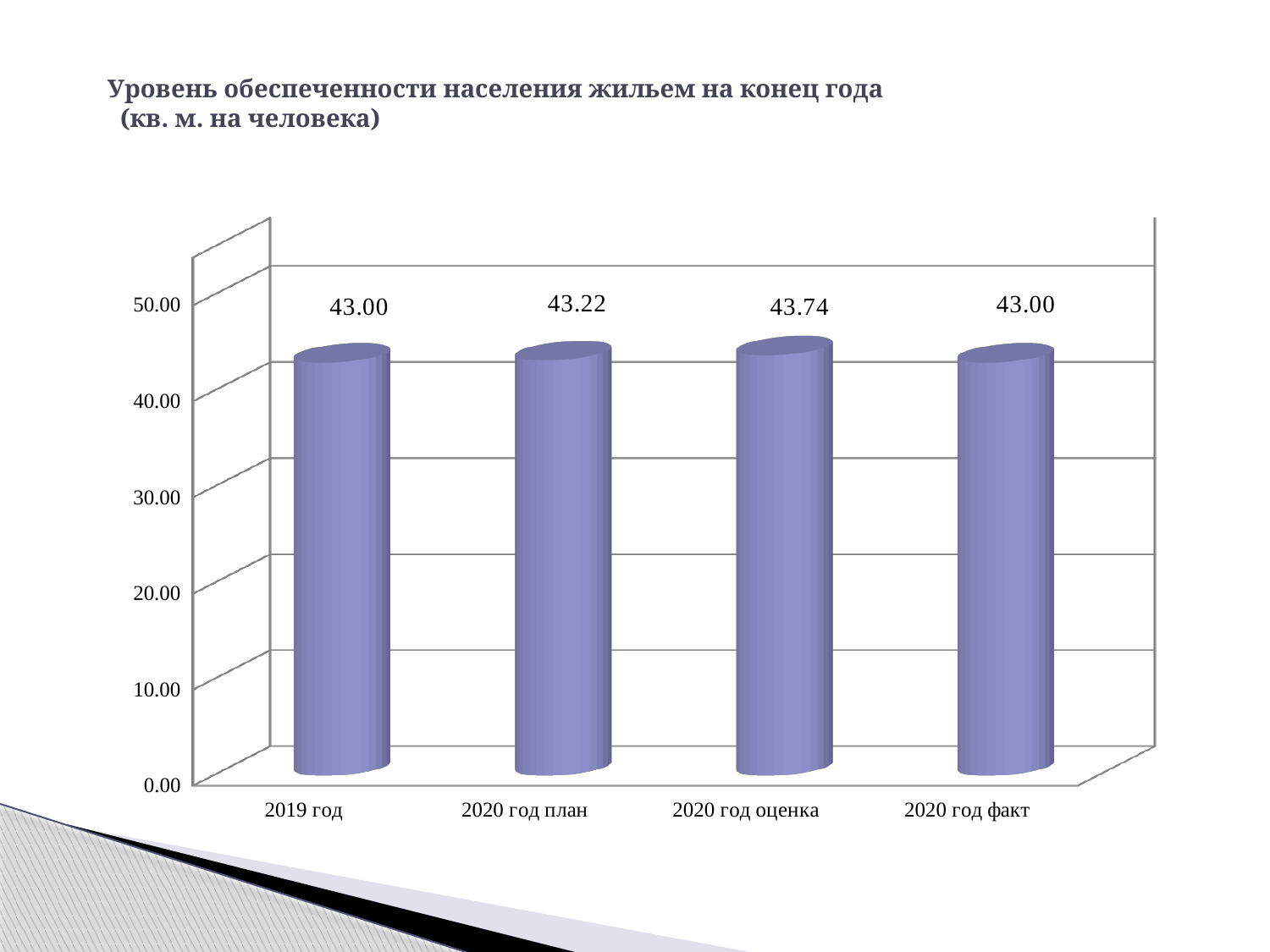
What is the difference between the values for 2020 год оценка and 2020 год план? 0.52 What is the title of the chart? Уровень обеспеченности населения жильем на конец года (кв. м. на человека) What is the value for 2020 год факт? 43.00 How many categories are shown on the x axis? 4 What is the value for 2020 год оценка? 43.74 What kind of chart is shown on the slide? bar chart What is the value for 2020 год план? 43.22 Is the value for 2019 год greater or less than 40.00? greater What is the difference between the values for 2020 год план and 2019 год? 0.22 Which is larger, the value for 2020 год оценка or the value for 2020 год факт? 2020 год оценка What is the value for 2019 год? 43.00 Which category has the highest value? 2020 год оценка